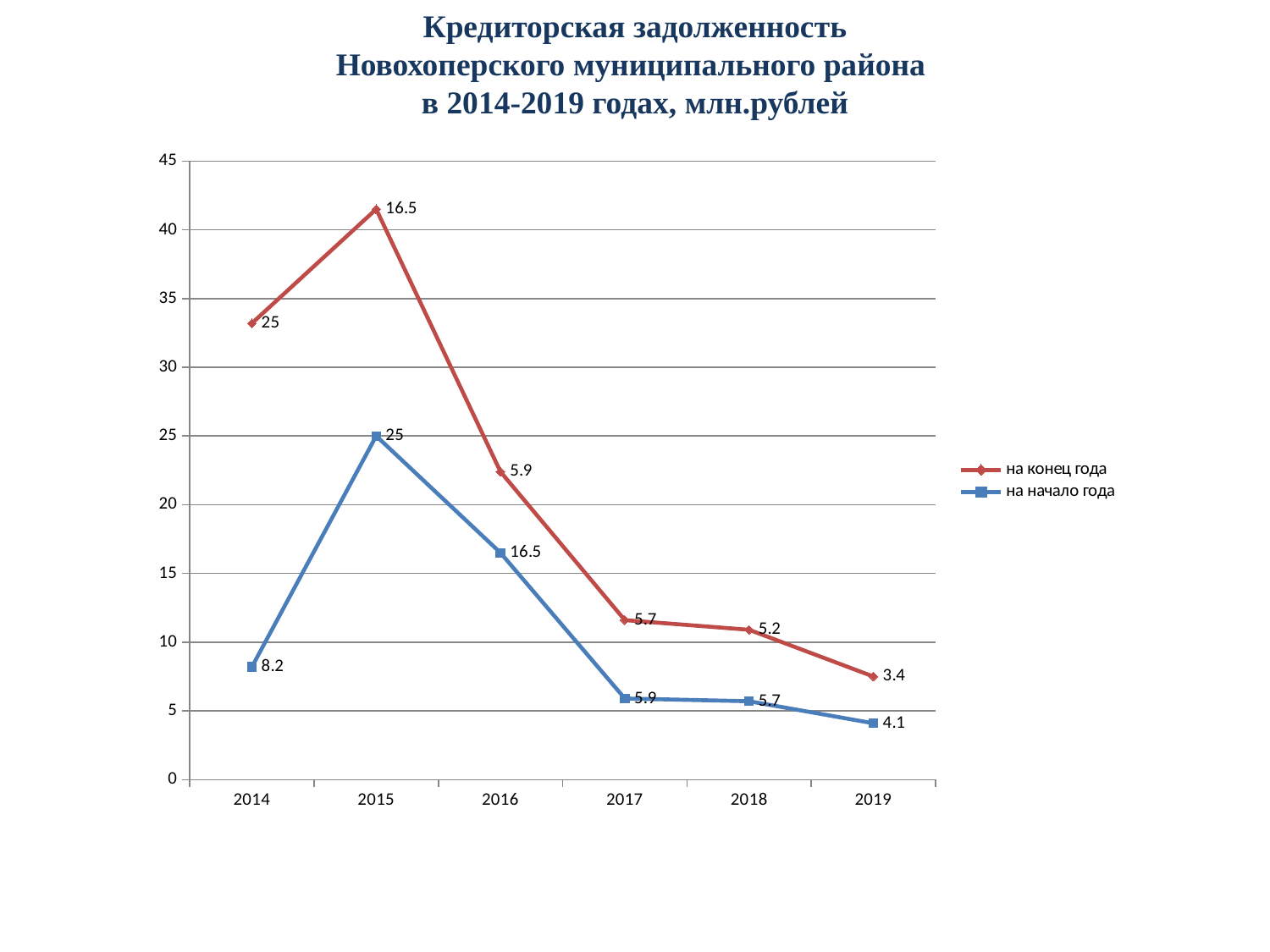
In which year is the "на конец года" value lowest? 2019 How many series does the legend list? 2 What is the value for "на конец года" in 2015? 16.5 What is the value for "на конец года" in 2019? 3.4 In which year is the "на начало года" value lowest? 2019 In which year is the "на начало года" value highest? 2015 How many years are shown on the x axis? 6 What is the difference between the "на начало года" and "на конец года" values in 2015? 8.5 What is the value for "на начало года" in 2018? 5.7 What is the value for "на начало года" in 2014? 8.2 What kind of chart is this? line chart Which is larger for "на начало года": the value in 2015 or the value in 2016? 2015